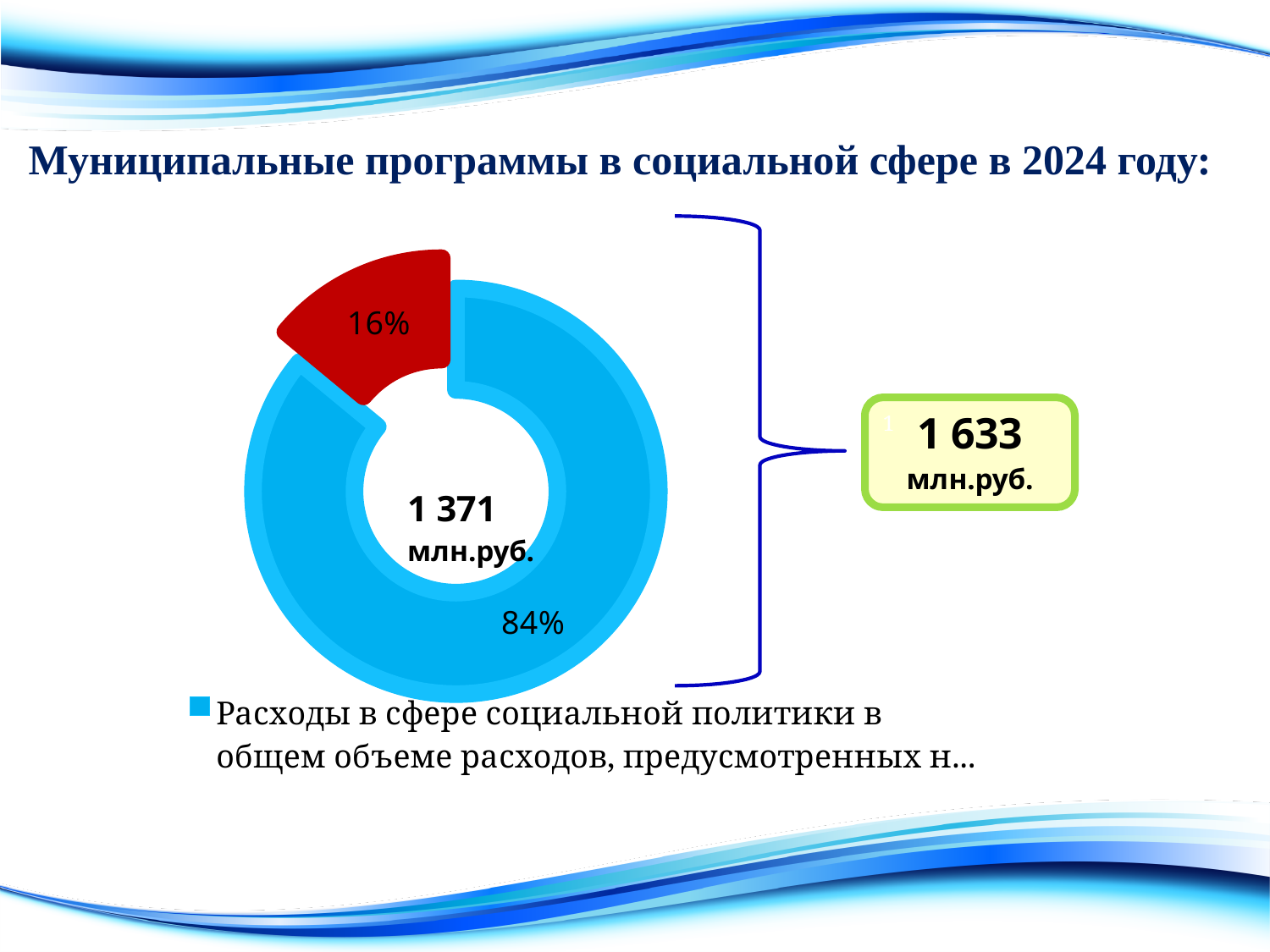
How many slices does the doughnut chart have? 2 What share of the doughnut chart does the red slice represent? 16% What is the title of the slide containing the chart? Муниципальные программы в социальной сфере в 2024 году: Which is larger, the blue slice or the red slice? The blue slice What is the difference in percentage points between the blue slice and the red slice? 68 percentage points Which slice of the doughnut chart is the largest? The blue slice (84%) What kind of chart is shown on the slide? Doughnut (pie) chart Which slice of the doughnut chart is the smallest? The red slice (16%) What share of the doughnut chart does the blue slice represent? 84% What value is printed in the centre of the doughnut chart? 1 371 млн.руб. What value is shown in the callout box to the right of the chart? 1 633 млн.руб. What colour is the slice labelled 16%? Red